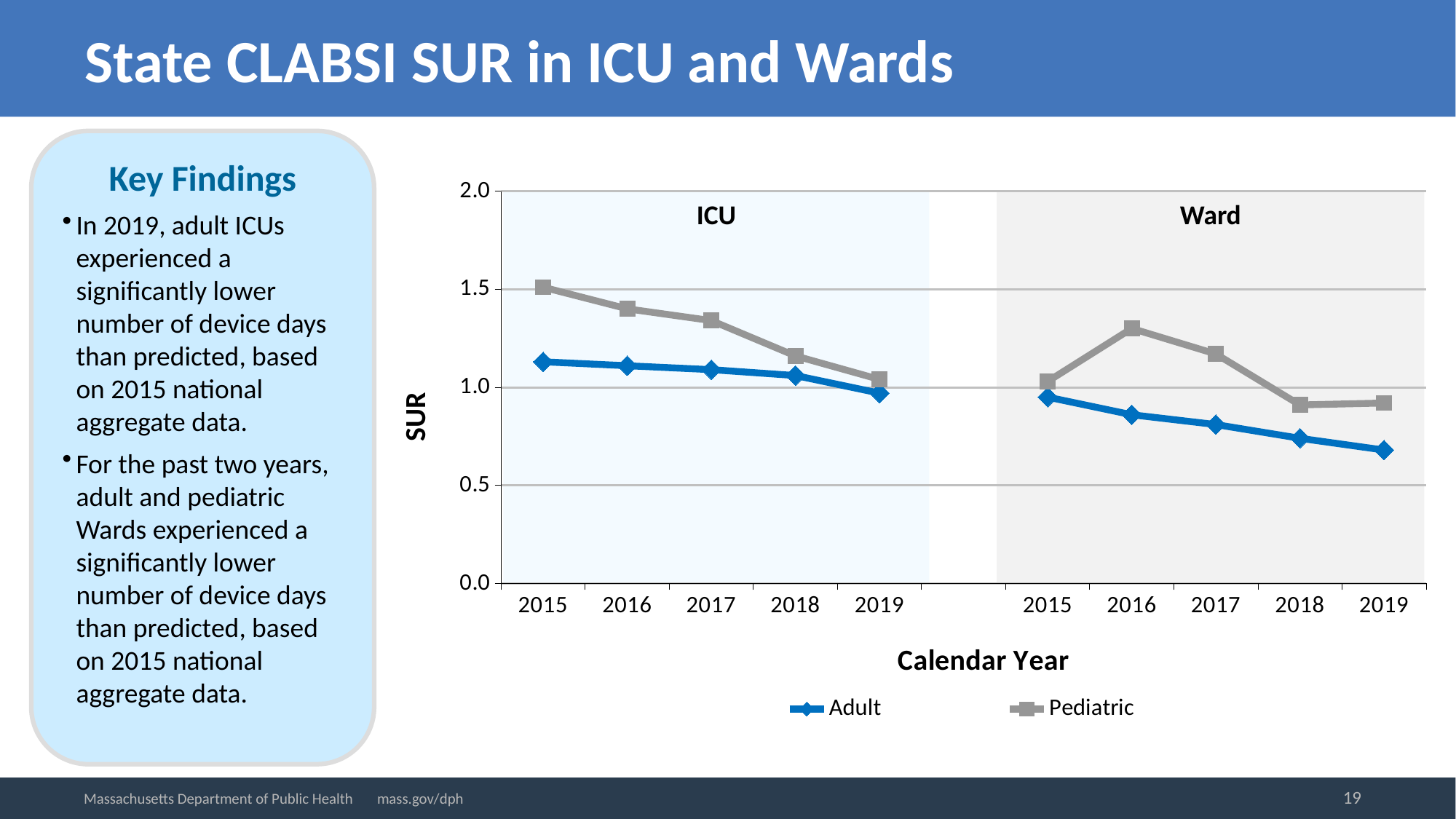
In the Ward section, which year has the highest Pediatric SUR? 2016 In the Ward section, which year has the lowest Adult SUR? 2019 How many series does the legend list? 2 Is the Adult Ward SUR for 2019 greater or less than 0.5? greater Is the Pediatric ICU SUR for 2016 greater or less than 1.5? less Is the Adult ICU SUR for 2015 greater or less than 1.0? greater What kind of chart is shown on the slide? Line chart What is the title of the x axis? Calendar Year How many years are plotted on the x axis for the ICU section? 5 In the ICU section for 2015, which is larger, the Adult SUR or the Pediatric SUR? Pediatric In the ICU section, which year has the highest Pediatric SUR? 2015 In the ICU section, does the Adult SUR rise or fall from 2015 to 2019? Fall